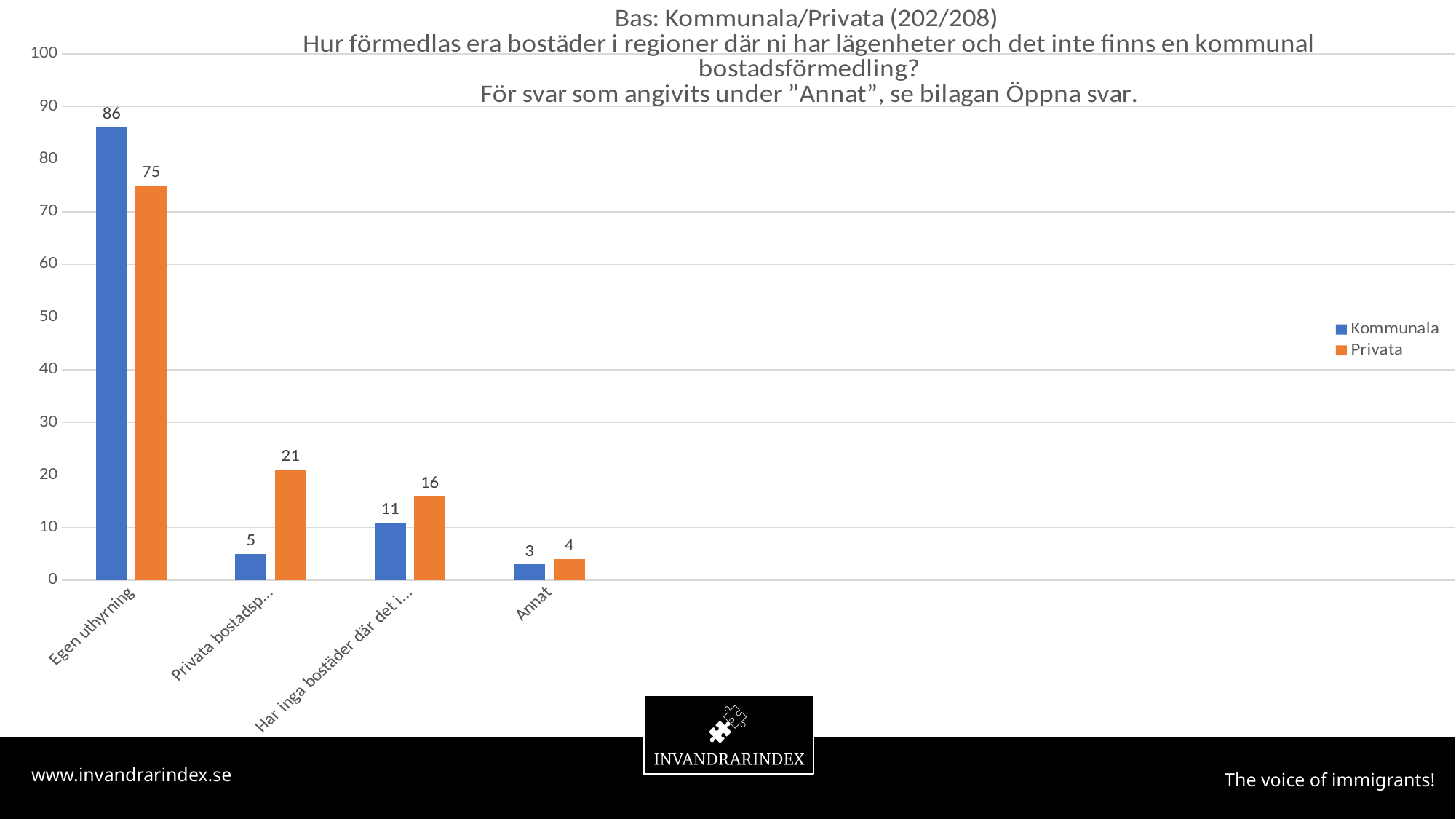
What is the Privata value for Egen uthyrning? 75 What kind of chart is shown on the slide? Bar chart For the category labelled "Privata bostadsp...", which series has the larger value, Kommunala or Privata? Privata What is the Kommunala value for Egen uthyrning? 86 Which category has the highest Kommunala value? Egen uthyrning Which category has the lowest Privata value? Annat How many categories are shown on the x axis? 4 What is the Kommunala value for the category labelled "Har inga bostäder där det i..."? 11 What is the difference between the Kommunala and Privata values for Egen uthyrning? 11 How many series does the legend list? 2 What is the Kommunala value for Annat? 3 What is the Privata value for the category labelled "Privata bostadsp..."? 21